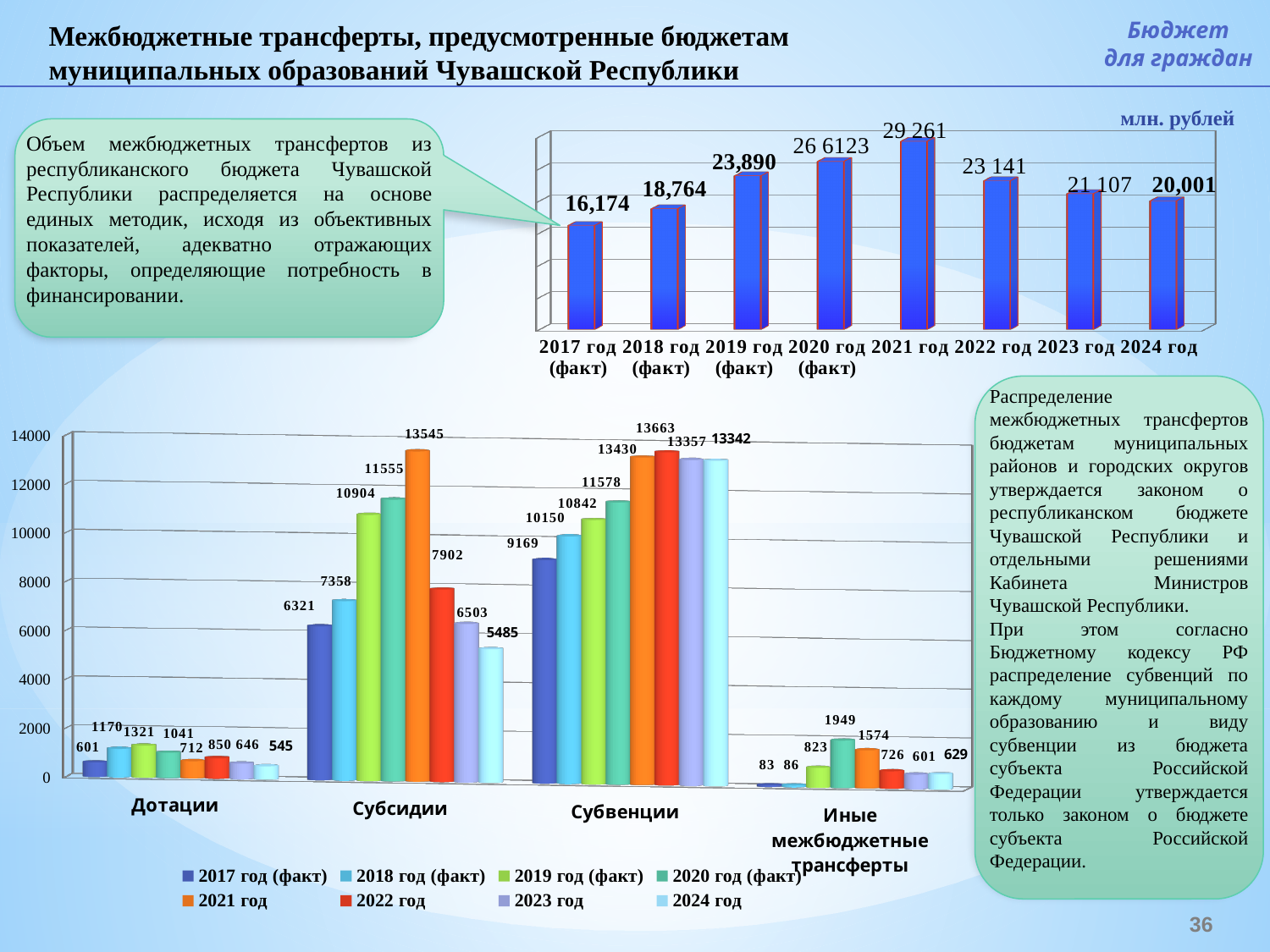
On the bottom chart, what is the difference between the Субвенции values for 2022 год and 2017 год (факт)? 4494 On the top chart, which year has the lowest value? 2017 год (факт) On the bottom chart, how many series does the legend list? 8 On the top chart, what is the value for 2017 год (факт)? 16,174 On the top chart, which year has the highest value? 2021 год What kind of chart is the bottom chart? bar chart On the top chart, how many years are plotted? 8 On the bottom chart, what is the value for Субсидии in 2021 год? 13545 On the top chart, is the value for 2024 год larger or smaller than the value for 2023 год? smaller On the bottom chart, which category has the highest value in 2024 год? Субвенции On the top chart, what is the value for 2021 год? 29 261 On the bottom chart, what is the value for Иные межбюджетные трансферты in 2020 год (факт)? 1949